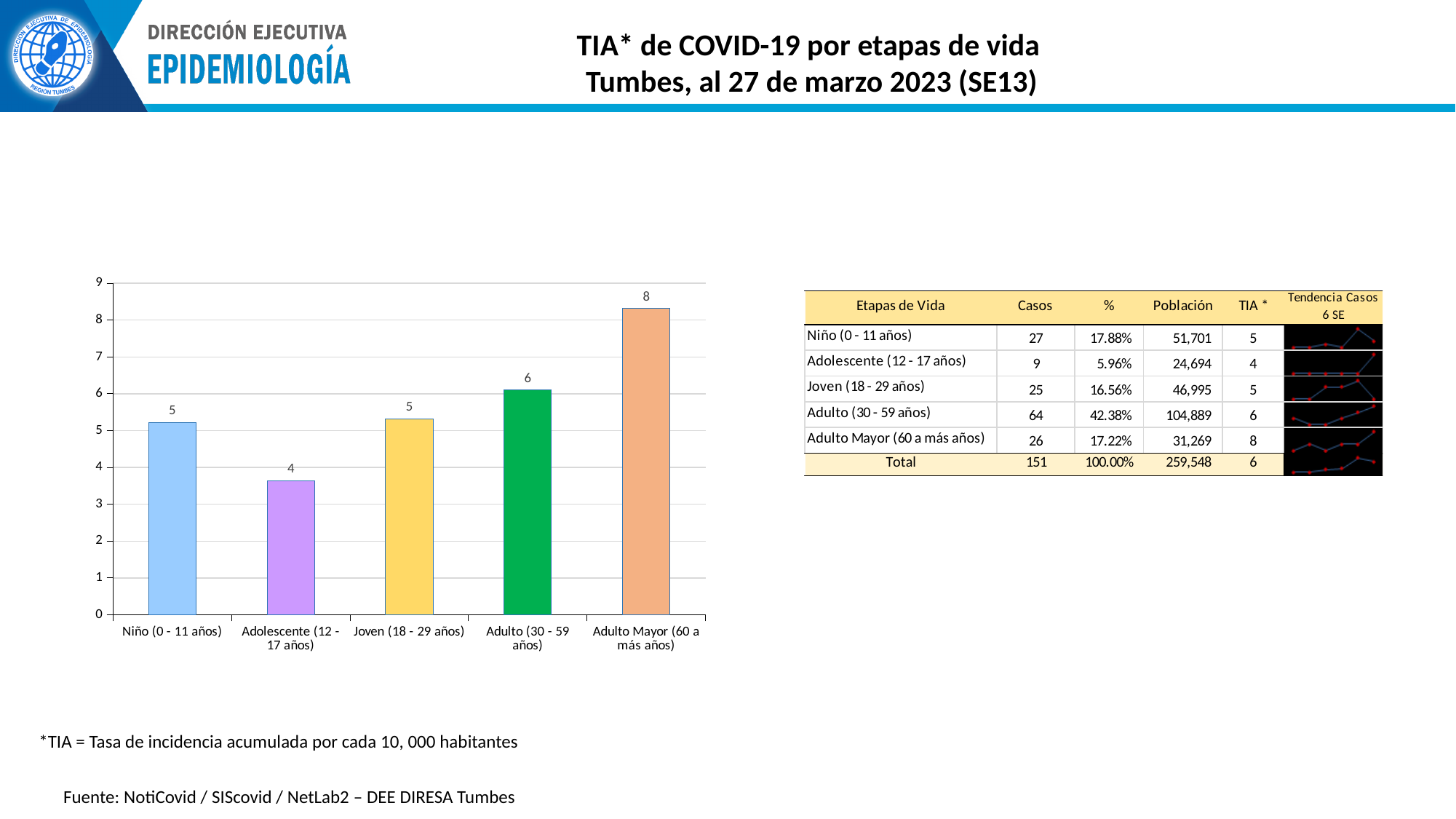
What is the TIA value shown for Adulto (30 - 59 años) in the bar chart? 6 Which age group has the highest bar in the chart? Adulto Mayor (60 a más años) What is the TIA value shown for Adolescente (12 - 17 años) in the bar chart? 4 Using the data labels, what is the difference between the values for Adulto Mayor (60 a más años) and Adolescente (12 - 17 años)? 4 What colour is the bar for Adulto (30 - 59 años)? green What is the TIA value shown for Niño (0 - 11 años) in the bar chart? 5 What kind of chart is shown on the slide? bar chart Which age group has the lowest bar in the chart? Adolescente (12 - 17 años) How many age-group categories are plotted in the bar chart? 5 What is the TIA value shown for Adulto Mayor (60 a más años) in the bar chart? 8 Which is larger in the bar chart, the value for Adulto (30 - 59 años) or the value for Adolescente (12 - 17 años)? Adulto (30 - 59 años) Is the bar for Adulto (30 - 59 años) greater or less than 5? greater